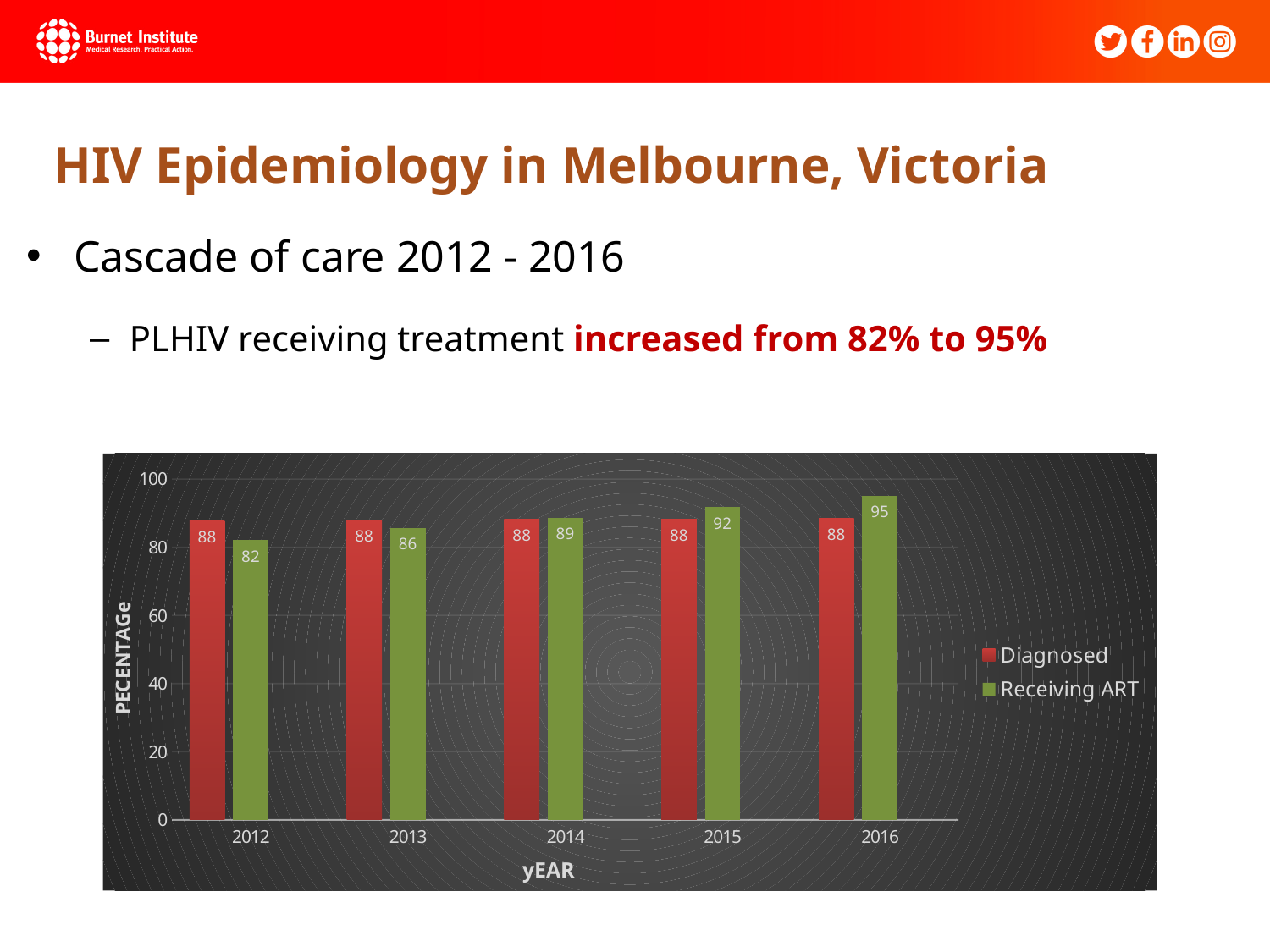
What kind of chart is shown on the slide? Bar chart What is the difference between the Receiving ART values in 2016 and 2012? 13 What is the value for Receiving ART in 2012? 82 In 2013, which is larger: Diagnosed or Receiving ART? Diagnosed How many years are shown on the x axis? 5 Do the Receiving ART values rise or fall from 2012 to 2016? Rise What is the value for Diagnosed in 2015? 88 Is the value for Receiving ART in 2015 greater or less than 80? greater In which year is the Receiving ART value highest? 2016 How many series does the legend list? 2 In which year is the Receiving ART value lowest? 2012 What is the value for Receiving ART in 2016? 95